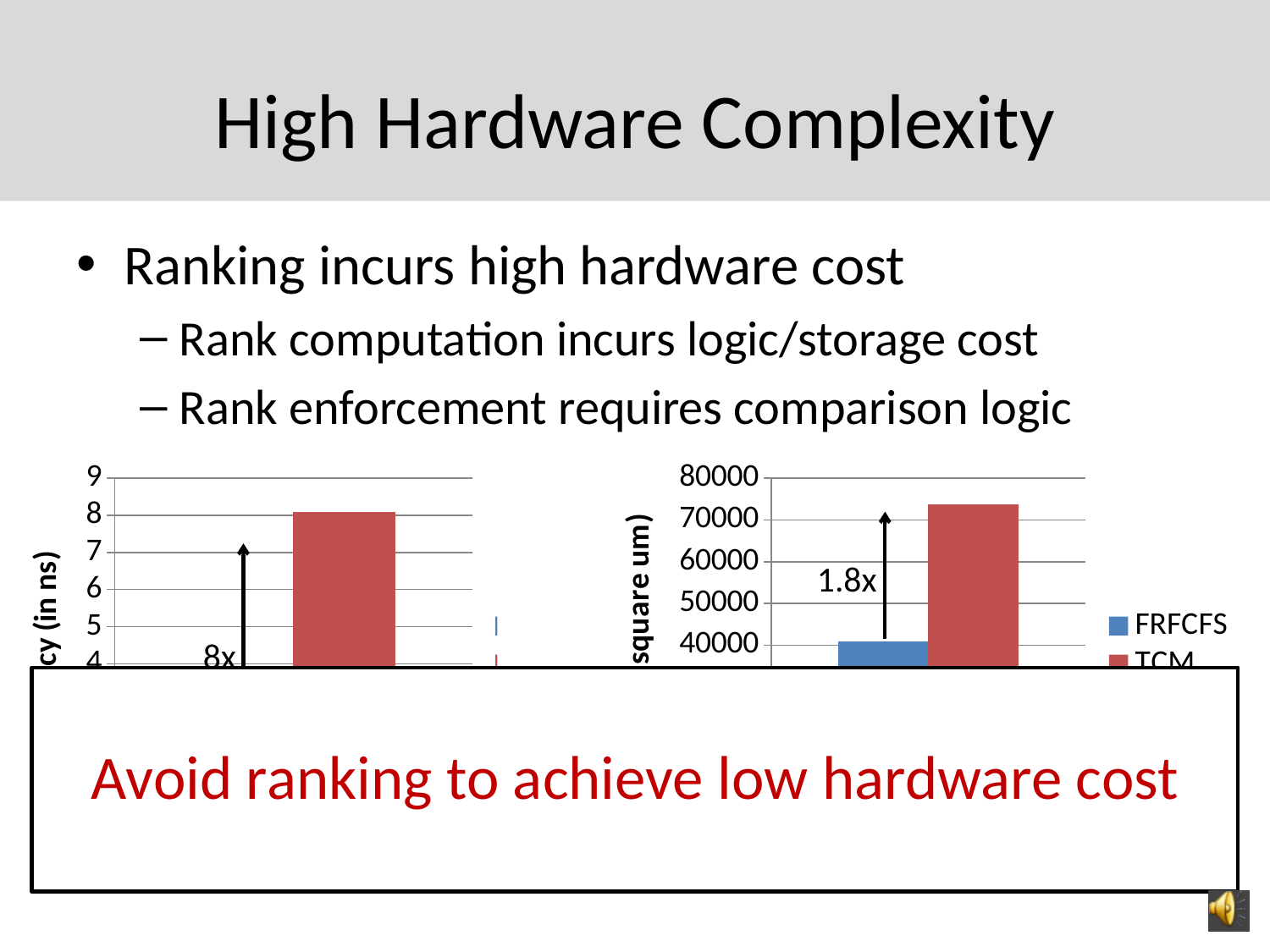
In the chart on the right, which series has the lowest value? FRFCFS In the chart on the right, how many series does the legend list? 2 In the chart on the right, is the value for FRFCFS greater or less than 50000? less In the chart on the left, is the value for TCM greater or less than 7? greater What kind of chart is the chart on the right of the slide? bar chart What kind of chart is the chart on the left of the slide? bar chart In the chart on the right, what ratio is written next to the arrow between the two bars? 1.8x In the chart on the right, which series has the highest value? TCM In the chart on the right, which series has the taller bar, FRFCFS or TCM? TCM In the chart on the left, what ratio is written next to the arrow? 8x In the chart on the right, is the value for TCM greater or less than 70000? greater